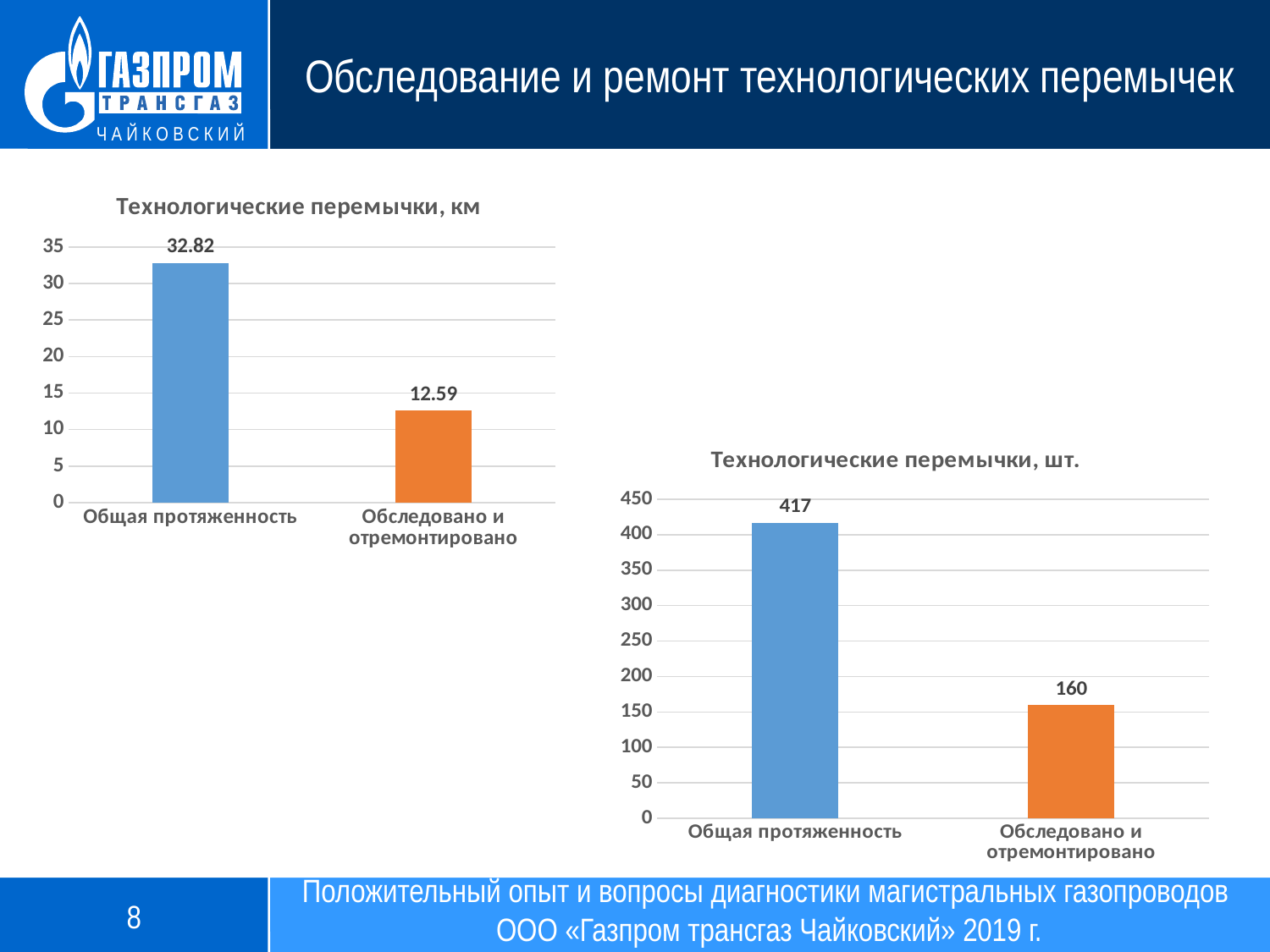
In the chart titled "Технологические перемычки, км", what is the difference between "Общая протяженность" and "Обследовано и отремонтировано"? 20.23 In the chart titled "Технологические перемычки, км", which category has the highest value? Общая протяженность In the chart titled "Технологические перемычки, шт.", what is the value for "Обследовано и отремонтировано"? 160 In the chart titled "Технологические перемычки, км", what is the value for "Обследовано и отремонтировано"? 12.59 In the chart titled "Технологические перемычки, шт.", what is the value for "Общая протяженность"? 417 In the chart titled "Технологические перемычки, шт.", is the value for "Обследовано и отремонтировано" greater or less than 200? less What kind of chart is the chart titled "Технологические перемычки, шт."? bar chart In the chart titled "Технологические перемычки, шт.", which category has the lowest value? Обследовано и отремонтировано How many categories are shown in the chart titled "Технологические перемычки, км"? 2 In the chart titled "Технологические перемычки, км", what colour is the bar for "Обследовано и отремонтировано"? orange In the chart titled "Технологические перемычки, шт.", what is the difference between "Общая протяженность" and "Обследовано и отремонтировано"? 257 In the chart titled "Технологические перемычки, км", what is the value for "Общая протяженность"? 32.82